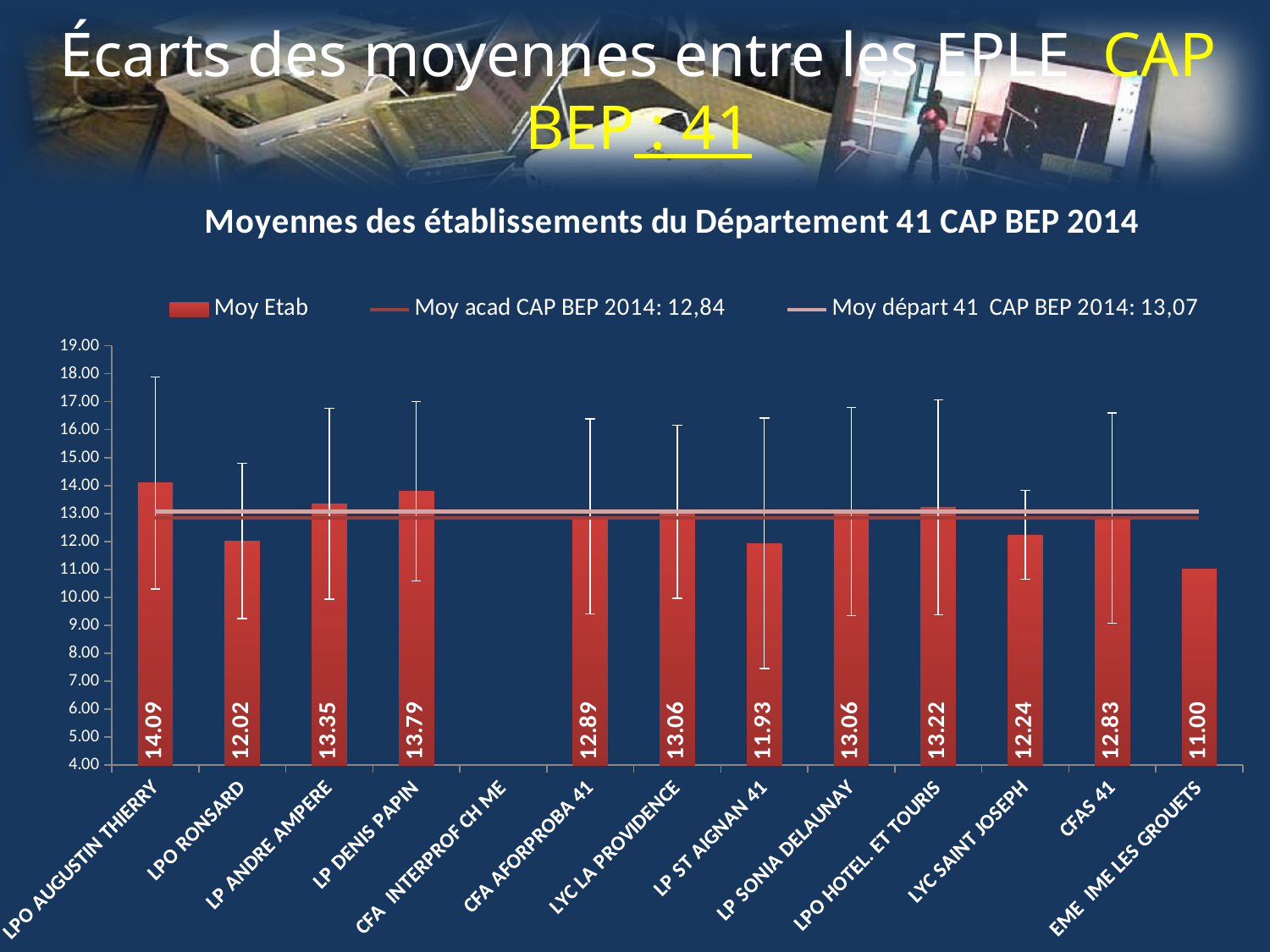
Which is larger, the value for LP ANDRE AMPERE or the value for LYC SAINT JOSEPH? LP ANDRE AMPERE What is the title of the chart? Moyennes des établissements du Département 41 CAP BEP 2014 What is the value for LP DENIS PAPIN? 13.79 What kind of chart is this? Combination bar and line chart How many series does the legend list? 3 What is the value for EME IME LES GROUETS? 11.00 Which establishment has the lowest value? EME IME LES GROUETS What is the difference between the values for LPO AUGUSTIN THIERRY and LPO RONSARD? 2.07 What is the value for LPO AUGUSTIN THIERRY? 14.09 What is the value of the 'Moy départ 41 CAP BEP 2014' line according to the legend? 13,07 Which establishment has the highest value? LPO AUGUSTIN THIERRY What is the value for LP ST AIGNAN 41? 11.93